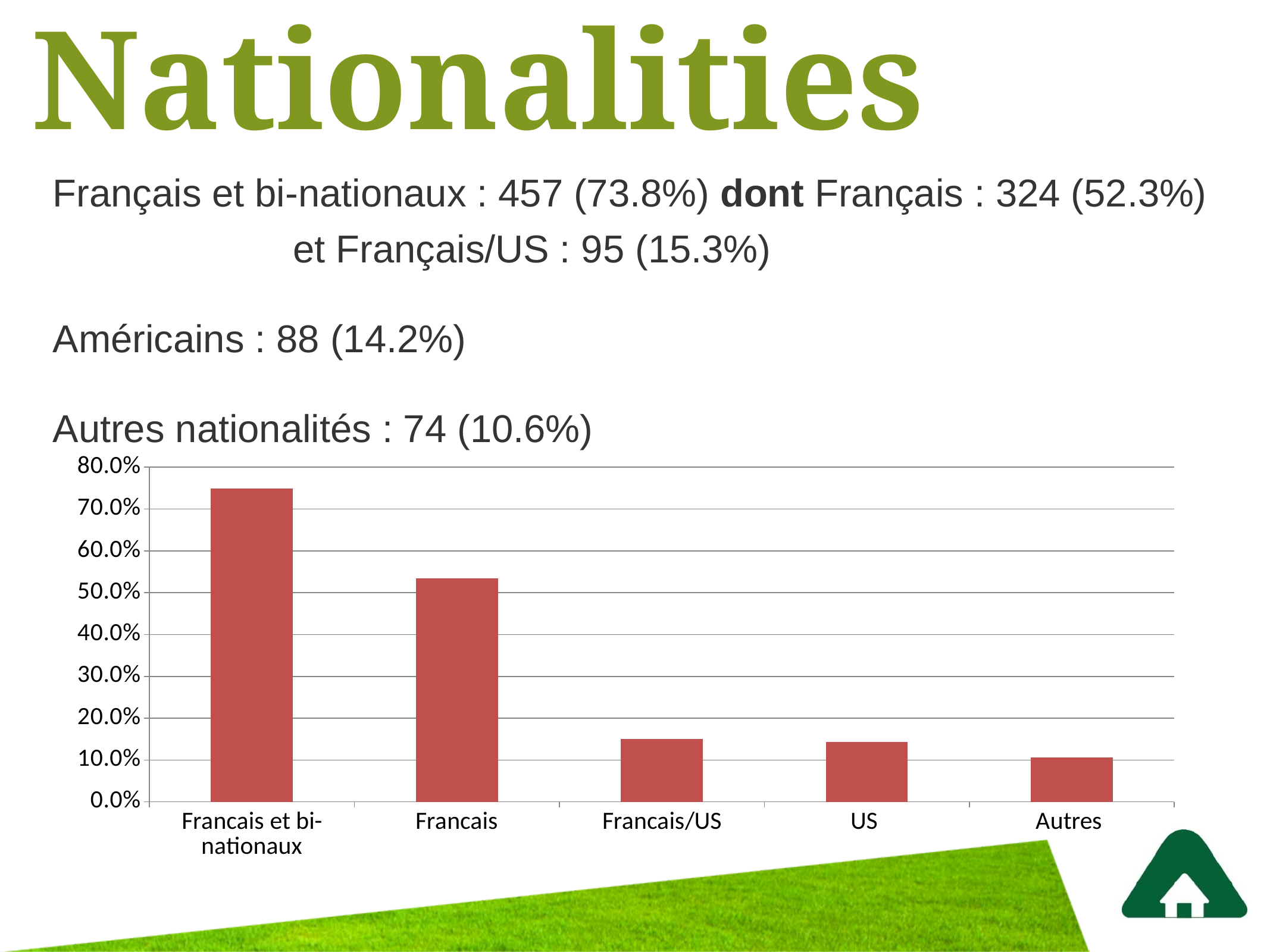
Is the value for Autres greater or less than 20.0%? less How many categories are shown on the x axis of the chart? 5 Is the value for Francais greater or less than 50.0%? greater Is the value for US greater or less than 10.0%? greater What kind of chart is shown on the slide? bar chart What is the highest value shown on the chart's y axis? 80.0% Do the bar values generally rise or fall from left to right along the x axis? fall Which category has the highest bar in the chart? Francais et bi-nationaux Which is larger, the value for Francais or the value for Francais/US? Francais Which category has the lowest bar in the chart? Autres